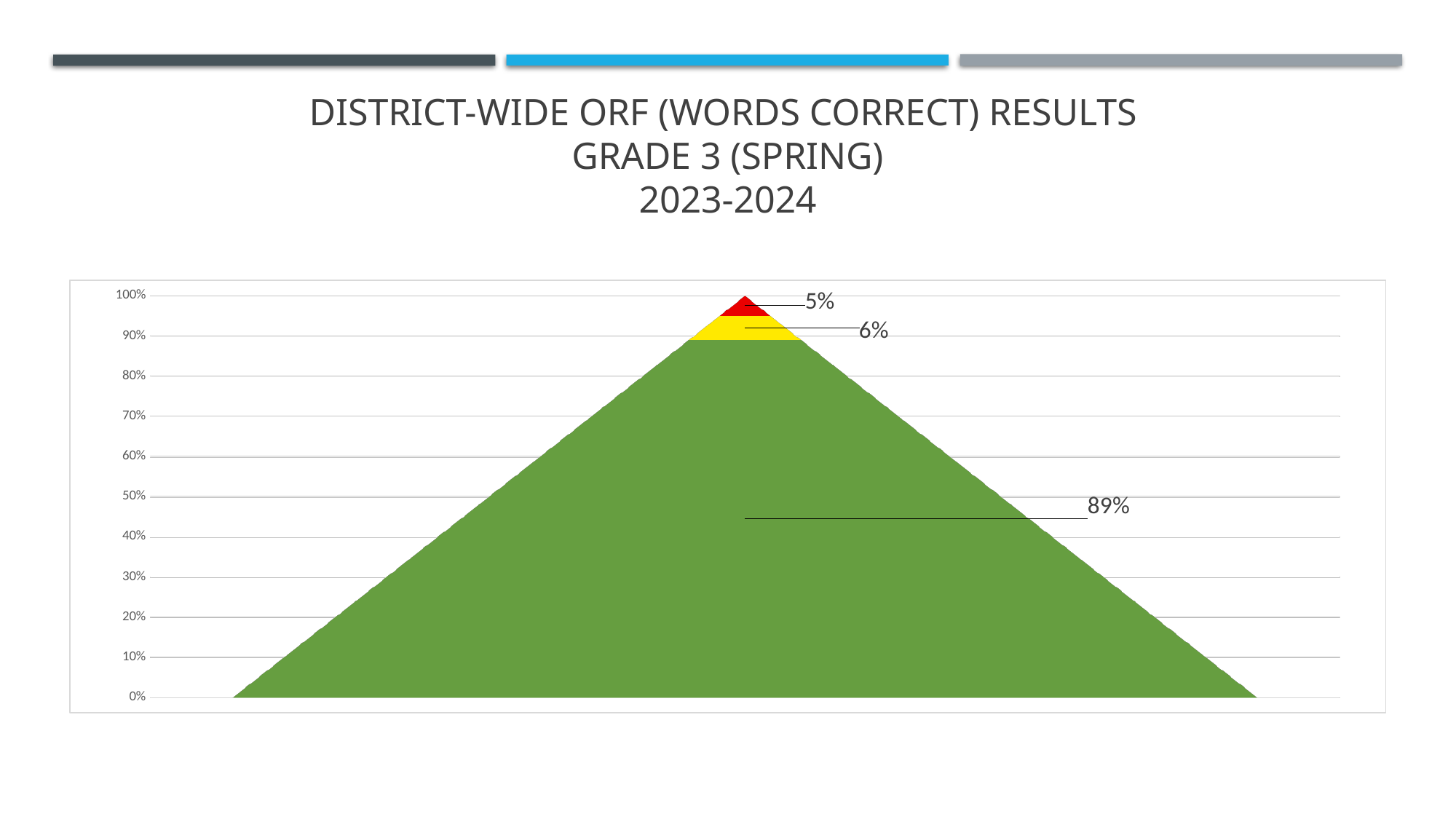
What grade and season does the chart title say the results are for? Grade 3 (Spring) Which is larger, the yellow segment's value or the red segment's value? Yellow Is the top of the green segment greater or less than 80% on the axis? greater What is the difference between the green segment's value and the yellow segment's value? 83% What is the total of the three labelled segments in the pyramid? 100% What is the difference between the yellow segment's value and the red segment's value? 1% Which coloured segment has the smallest value? Red Which coloured segment has the largest value? Green How many coloured segments make up the pyramid? 3 What value is labelled on the yellow segment of the pyramid? 6% What value is labelled on the red segment at the top of the pyramid? 5% What value is labelled on the green segment of the pyramid? 89%